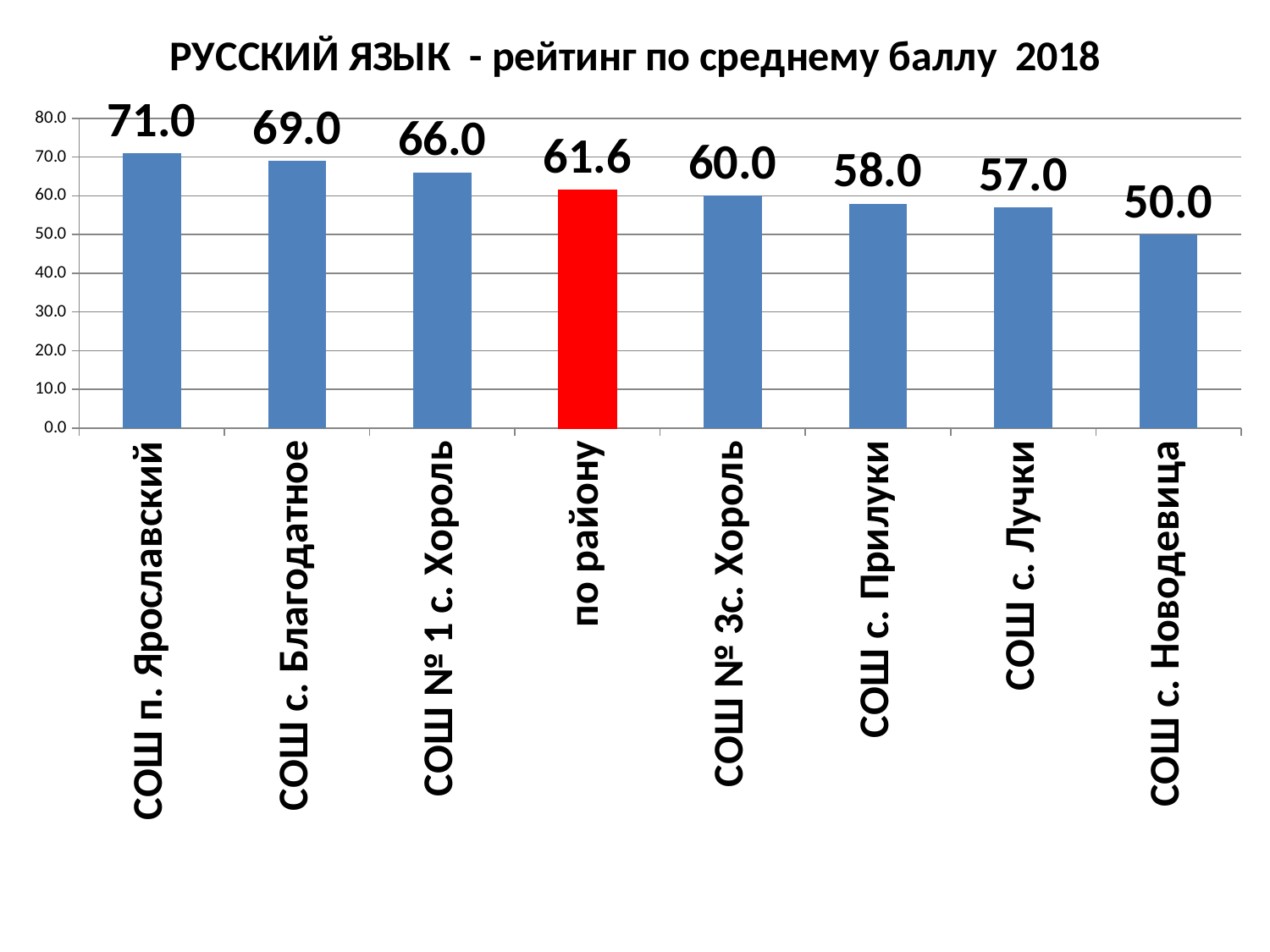
What is the value for СОШ п. Ярославский? 71.0 What is the difference between the values for СОШ с. Благодатное and СОШ с. Лучки? 12.0 What is the value for СОШ с. Прилуки? 58.0 How many categories are shown on the chart? 8 Which bar is coloured red? по району Which is larger, the value for СОШ № 3с. Хороль or the value for СОШ с. Новодевица? СОШ № 3с. Хороль Which category has the highest value? СОШ п. Ярославский What is the difference between the values for СОШ № 1 с. Хороль and по району? 4.4 Is the value for СОШ с. Лучки greater or less than 60.0? less Which category has the lowest value? СОШ с. Новодевица What is the value for по району? 61.6 What kind of chart is shown on the slide? bar chart